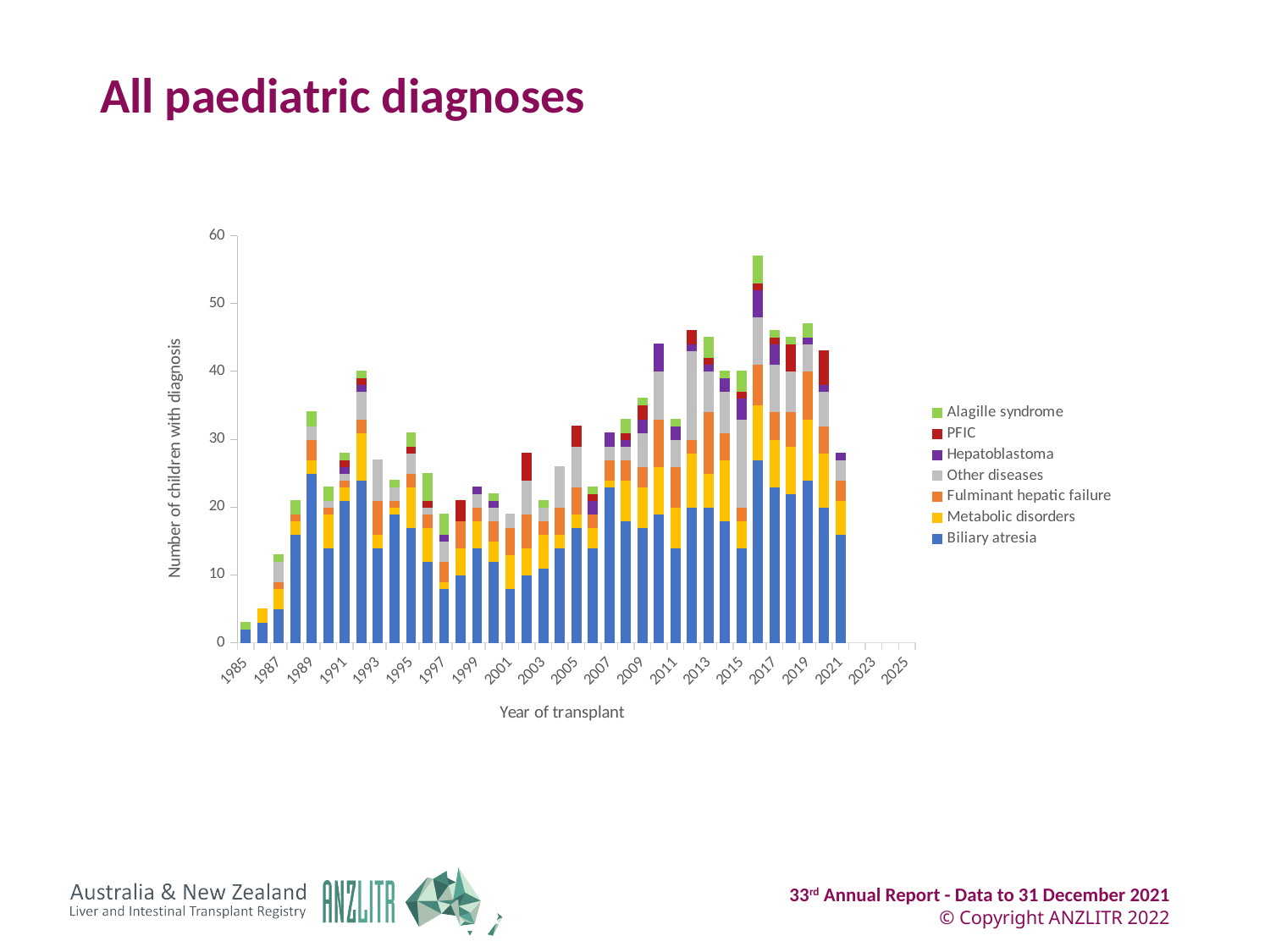
Do the total numbers of children rise or fall from 1985 to 1989? rise Is the total number of children for 2016 greater or less than 50? greater Which series is plotted at the bottom of each stacked bar, in blue? Biliary atresia Is the Biliary atresia value for 2016 greater or less than 20? greater Which year has a larger total number of children with a diagnosis, 2016 or 2021? 2016 What kind of chart is shown on the slide? Stacked bar chart Is the total number of children for 2012 greater or less than 40? greater What is the label on the vertical axis of the chart? Number of children with diagnosis How many series does the legend list? 7 Which year of transplant has the highest total number of children with a diagnosis? 2016 Which year of transplant has the lowest total number of children with a diagnosis? 1985